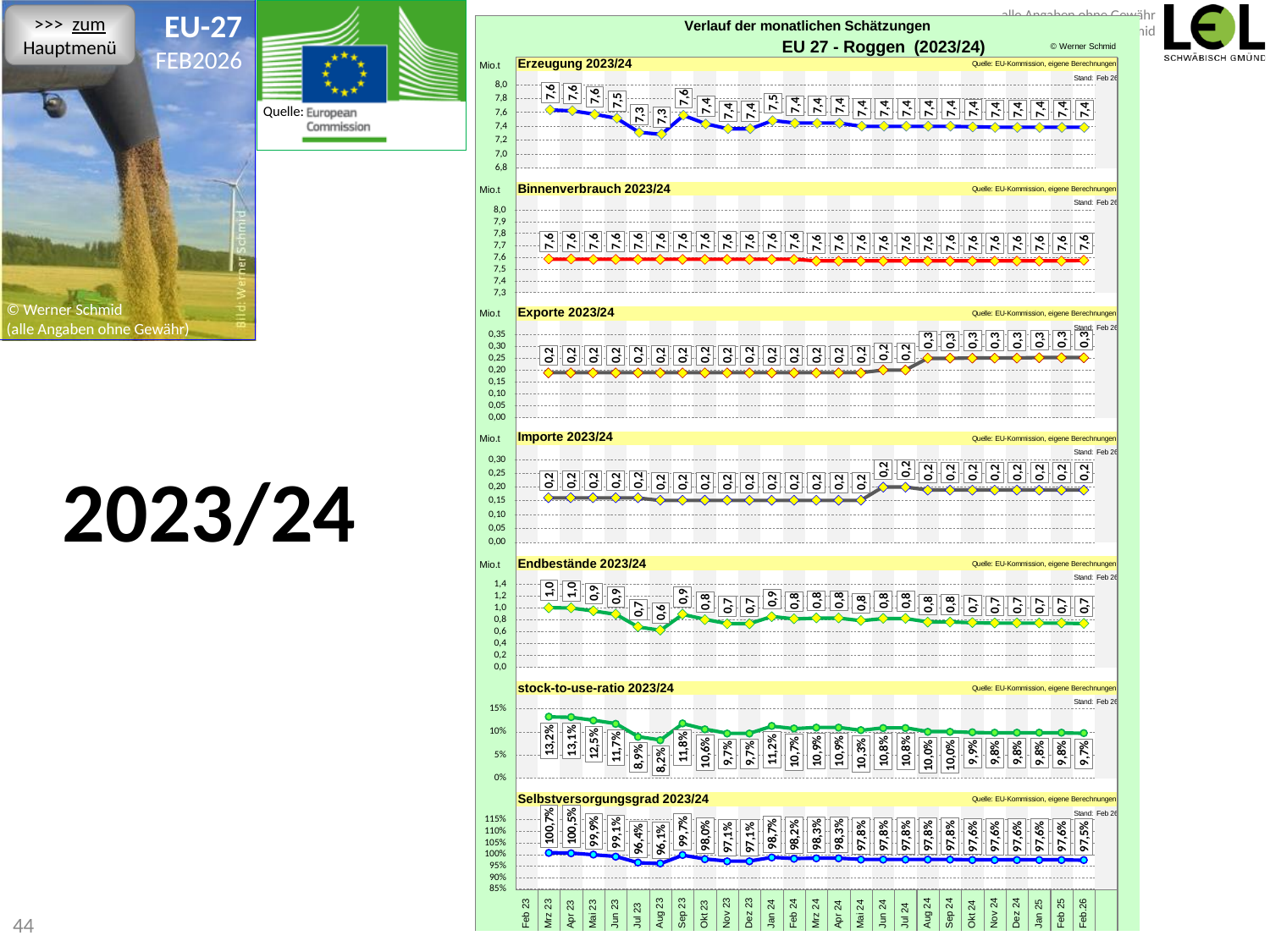
In the 'Endbestände 2023/24' chart, what is the lowest value shown? 0,6 How many separate chart panels are shown on the slide? 7 In the 'Selbstversorgungsgrad 2023/24' chart, what is the highest value shown? 100,7% Which crop and region does the chart title 'EU 27 - Roggen (2023/24)' refer to? Roggen, EU 27 In the 'Selbstversorgungsgrad 2023/24' chart, what is the value of the last data point on the right? 97,5% In the 'stock-to-use-ratio 2023/24' chart, what is the lowest value shown? 8,2% In the 'Selbstversorgungsgrad 2023/24' chart, what is the lowest value shown? 96,1% In the 'Binnenverbrauch 2023/24' chart, what value is shown for every data point? 7,6 In the 'stock-to-use-ratio 2023/24' chart, what is the difference between the highest value (13,2%) and the lowest value (8,2%)? 5,0% What type of chart is used for the 'Erzeugung 2023/24' panel? line chart In the 'Exporte 2023/24' chart, do the values rise or fall from left to right? rise In the 'stock-to-use-ratio 2023/24' chart, what is the highest value shown? 13,2%